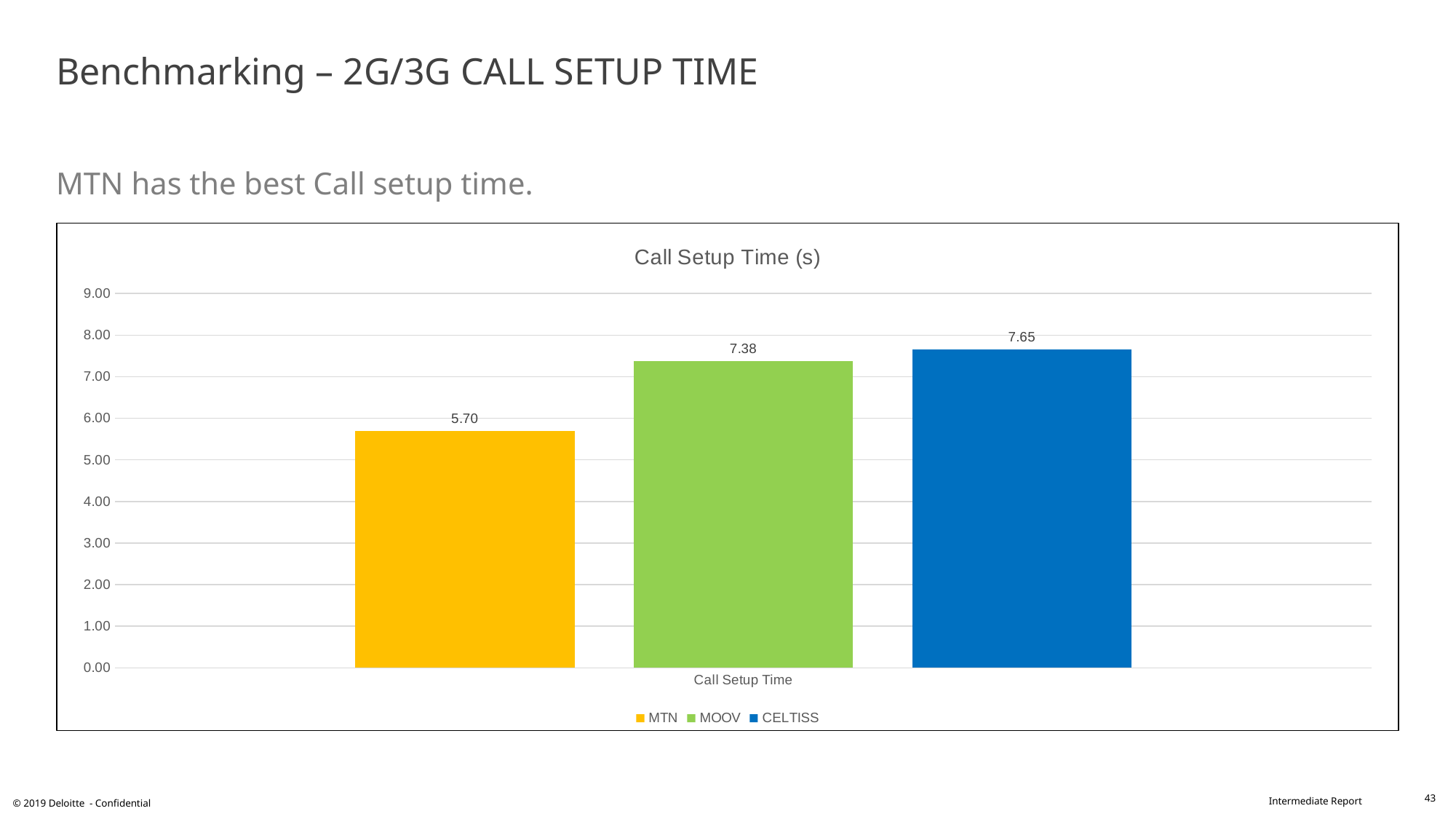
What kind of chart is shown on the slide? bar chart Is the call setup time for MTN greater or less than 6.00? less What is the call setup time for MTN? 5.70 Which has a larger call setup time, MOOV or MTN? MOOV What is the difference between the call setup times of MOOV and MTN? 1.68 Which operator has the lowest call setup time? MTN What is the title of the chart? Call Setup Time (s) What is the difference between the call setup times of CELTISS and MTN? 1.95 What is the call setup time for CELTISS? 7.65 How many series does the legend list? 3 What is the call setup time for MOOV? 7.38 Which operator has the highest call setup time? CELTISS